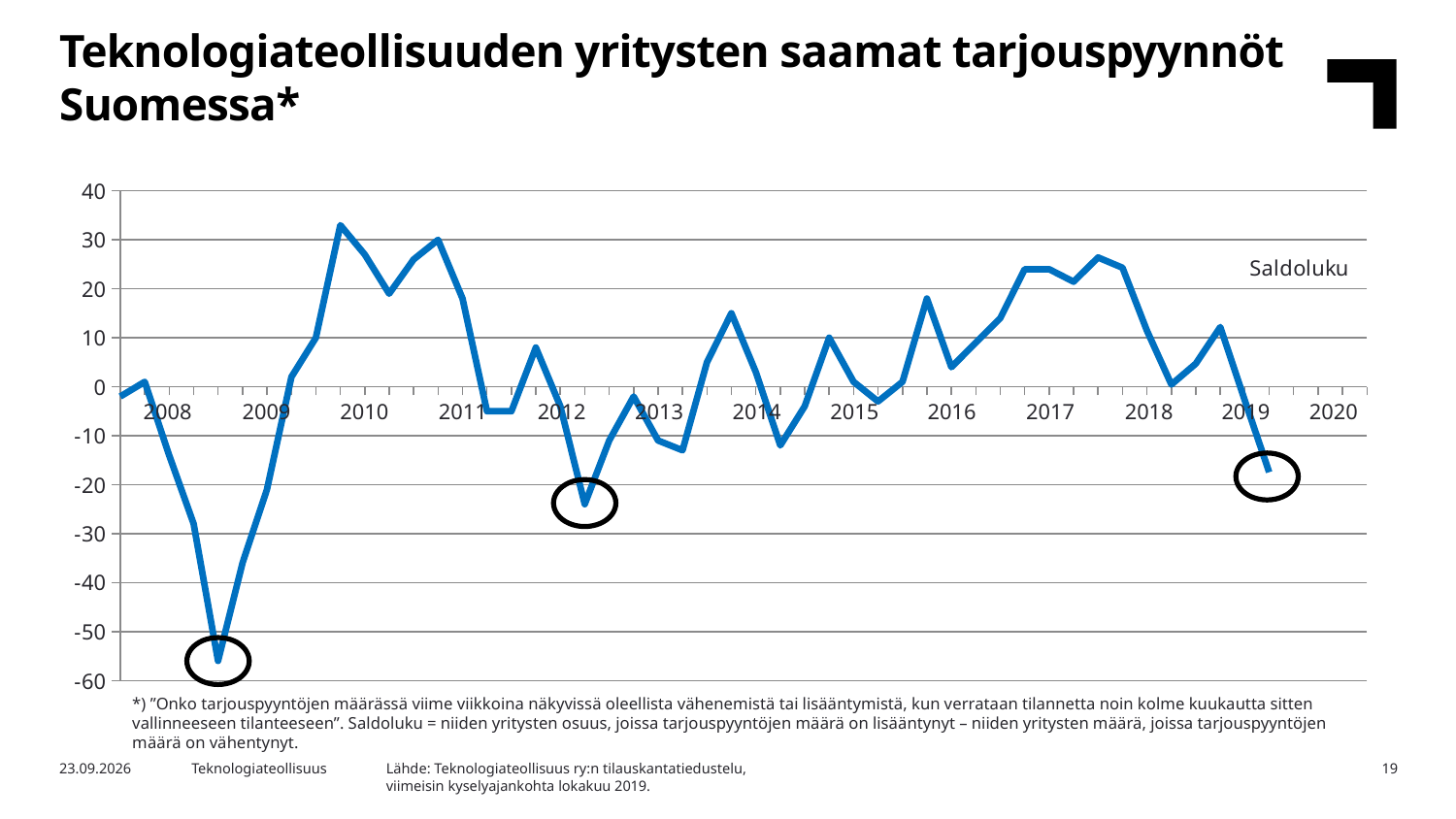
What is the name of the series shown in the legend? Saldoluku What kind of chart is shown on the slide? line chart How many points on the line are circled? 3 Which is higher, the peak of the line around 2010 or the peak around 2017? the peak around 2010 Is the highest point of the line, around 2010, greater or less than 30? greater Is the lowest point of the line (circled, around 2008–2009) greater or less than -50? less Is the peak of the line around 2017 greater or less than 20? greater Does the line rise or fall between 2018 and 2019? fall How many year labels are shown on the x axis? 13 How many series does the legend list? 1